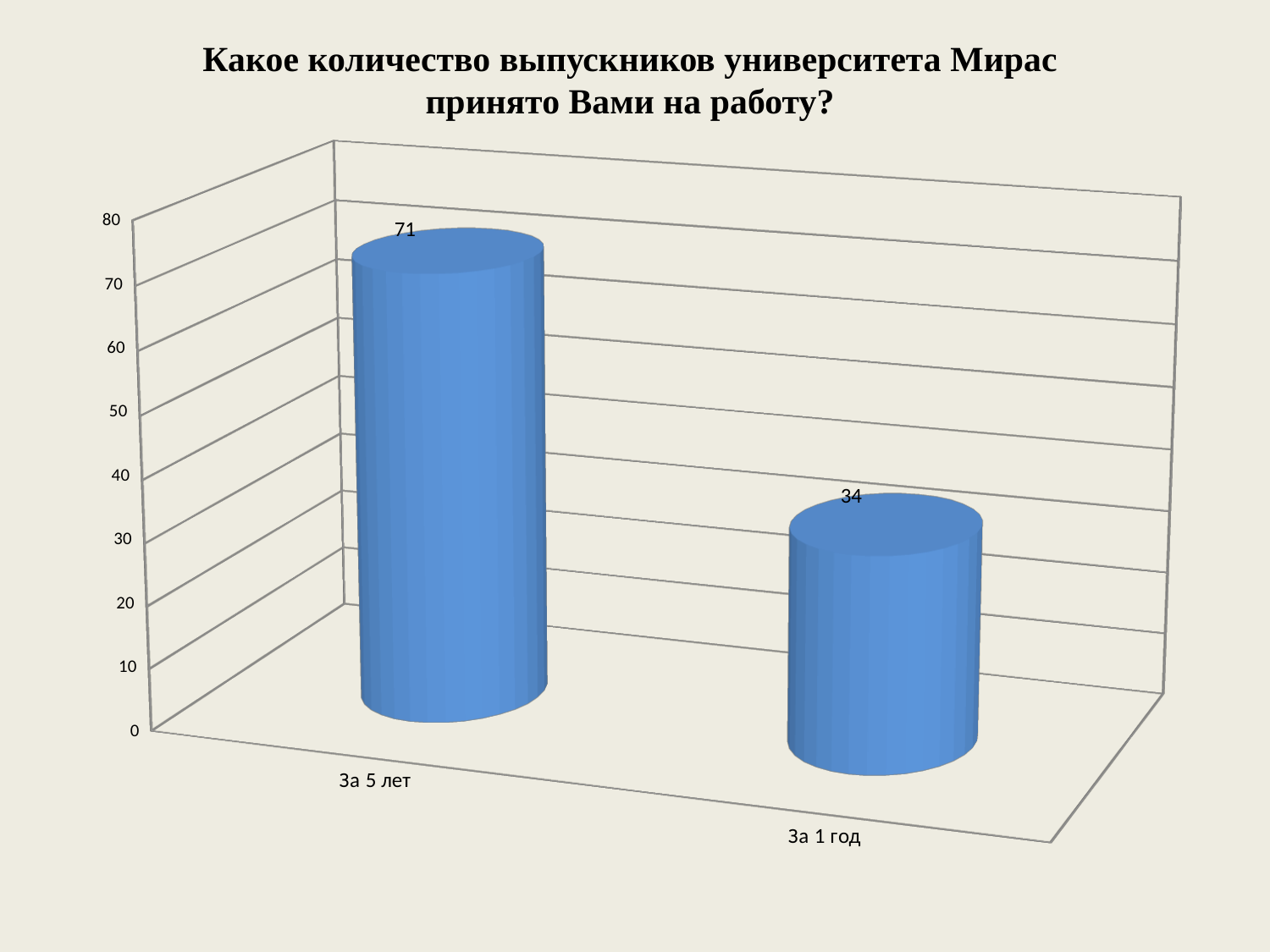
What kind of chart is shown on the slide? bar chart What is the title of the chart? Какое количество выпускников университета Мирас принято Вами на работу? What is the value for "За 5 лет"? 71 Which is larger, the value for "За 5 лет" or the value for "За 1 год"? За 5 лет Is the value for "За 5 лет" greater or less than 60? greater What is the difference between the values for "За 5 лет" and "За 1 год"? 37 Which category has the highest value? За 5 лет Is the value for "За 1 год" greater or less than 40? less What is the value for "За 1 год"? 34 How many categories are shown on the chart? 2 What is the highest value shown on the vertical axis? 80 Which category has the lowest value? За 1 год